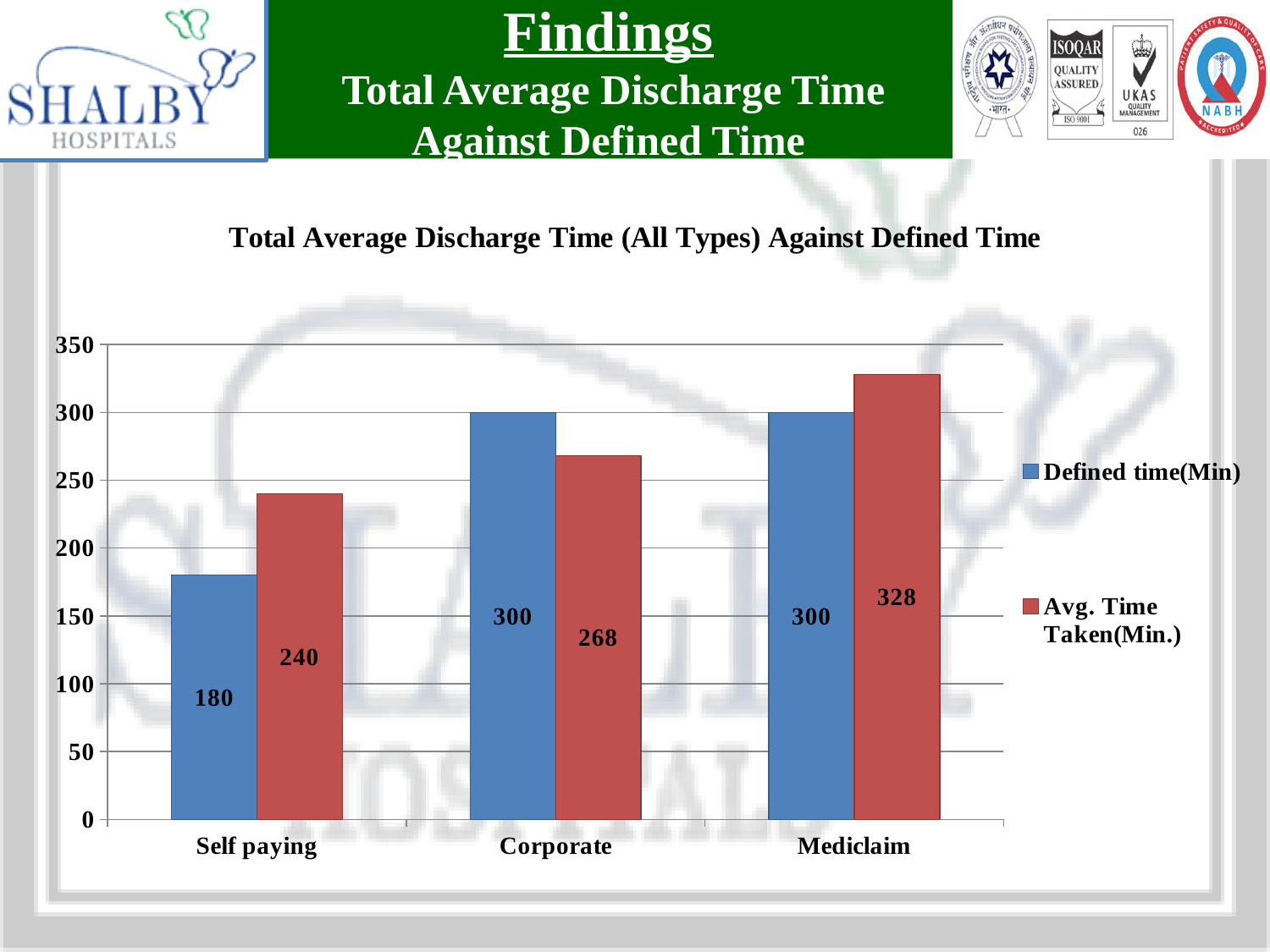
Which category has the highest Avg. Time Taken(Min.)? Mediclaim For Corporate, which is larger: the Defined time(Min) or the Avg. Time Taken(Min.)? Defined time(Min) What is the Avg. Time Taken(Min.) for Corporate? 268 Which category has the lowest Defined time(Min)? Self paying What kind of chart is shown? Bar chart What is the difference between the Avg. Time Taken(Min.) for Mediclaim and for Corporate? 60 What is the difference between the Avg. Time Taken(Min.) and the Defined time(Min) for Self paying? 60 How many categories are shown on the x axis? 3 Is the Avg. Time Taken(Min.) for Mediclaim greater or less than 300? greater How many series does the legend list? 2 What is the Avg. Time Taken(Min.) for Mediclaim? 328 What is the Defined time(Min) for Self paying? 180